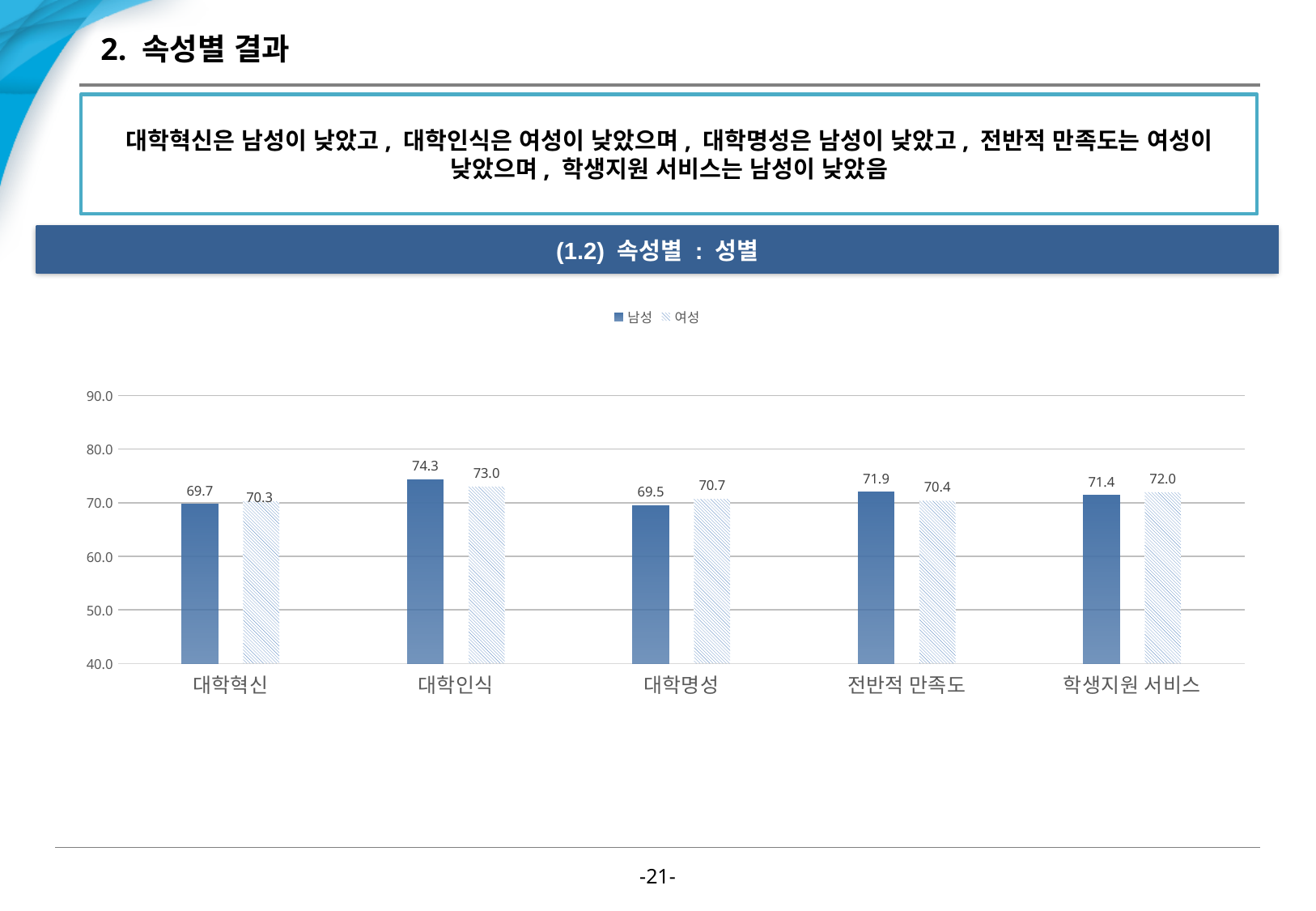
How many categories are shown on the x axis? 5 How many series does the legend list? 2 In the 대학명성 category, which is larger, the 남성 value or the 여성 value? 여성 What is the difference between the 남성 and 여성 values in the 대학인식 category? 1.3 What kind of chart is shown on the slide? bar chart What is the value for 여성 in the 학생지원 서비스 category? 72.0 Is the value for 여성 in the 대학혁신 category greater or less than 80.0? less What is the value for 남성 in the 전반적 만족도 category? 71.9 Which category has the lowest 남성 value? 대학명성 Which category has the highest 남성 value? 대학인식 What is the value for 여성 in the 대학인식 category? 73.0 What is the value for 남성 in the 대학혁신 category? 69.7